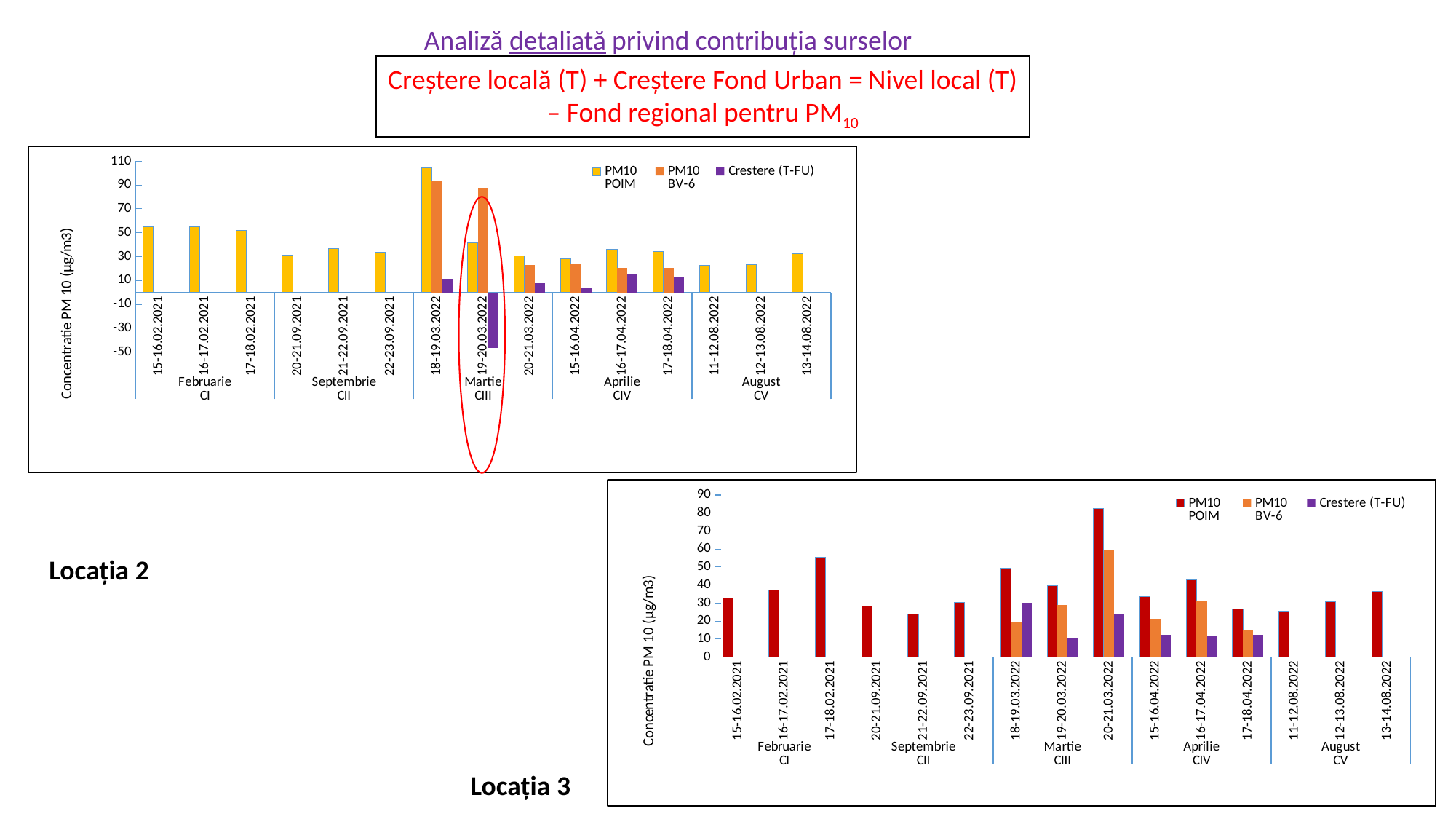
In the top chart (Locația 2), is the Crestere (T-FU) value for 19-20.03.2022 greater or less than -30? less In the bottom chart (Locația 3), which date has the highest Crestere (T-FU) value? 18-19.03.2022 In the bottom chart (Locația 3), is the PM10 POIM value for 20-21.03.2022 greater or less than 70? greater In the top chart (Locația 2), is the PM10 POIM value for 18-19.03.2022 greater or less than 90? greater How many dates are shown on the x axis of the bottom chart (Locația 3)? 15 How many series does the legend of the top chart (Locația 2) list? 3 In the bottom chart (Locația 3), which is larger for 20-21.03.2022: PM10 POIM or PM10 BV-6? PM10 POIM In the top chart (Locația 2), which date has the highest PM10 POIM value? 18-19.03.2022 In the top chart (Locația 2), which date has the lowest Crestere (T-FU) value? 19-20.03.2022 In the bottom chart (Locația 3), which date has the highest PM10 POIM value? 20-21.03.2022 What kind of chart is the bottom chart (Locația 3)? bar chart